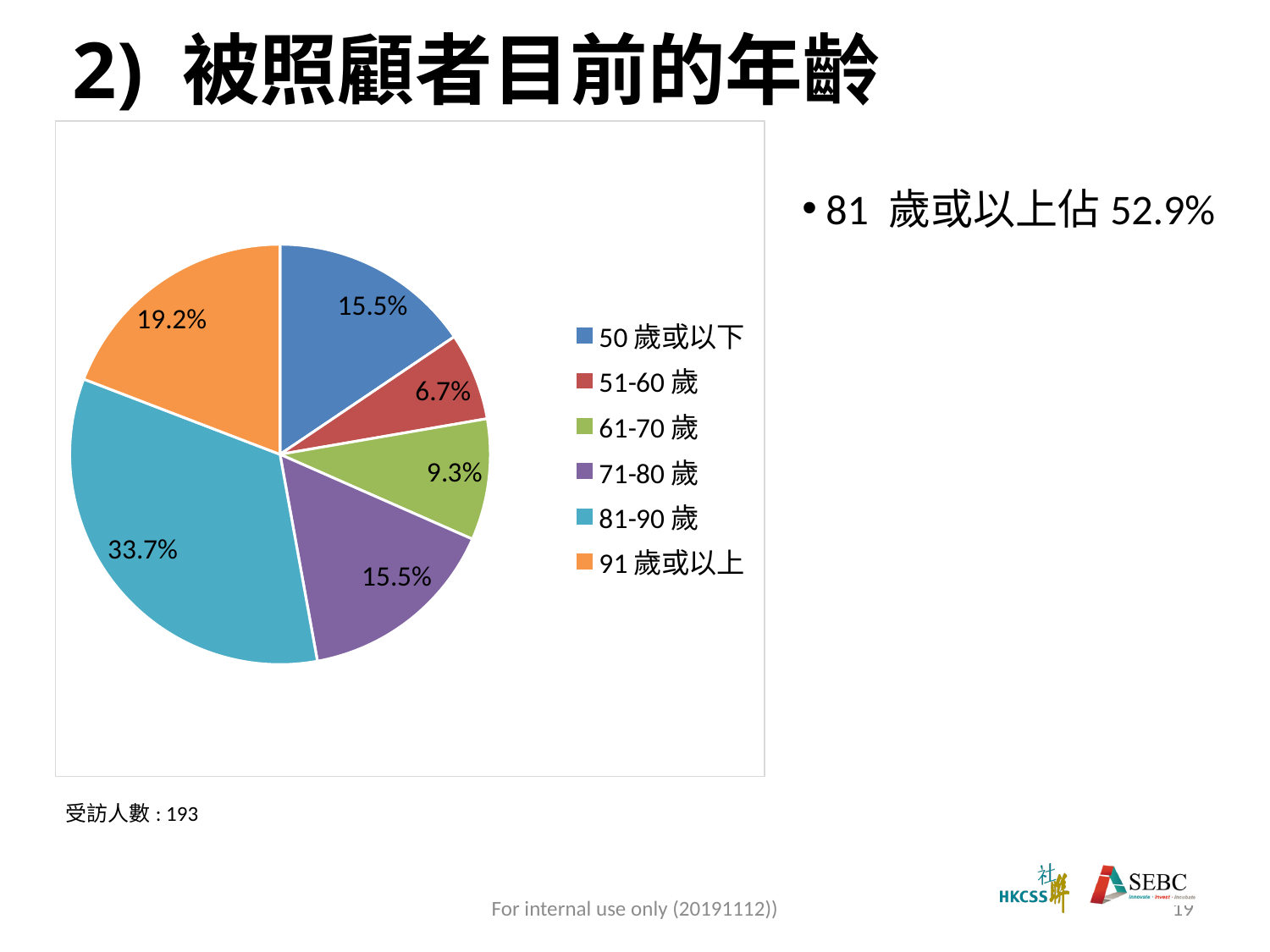
What percentage of the pie is the 51-60 歲 slice? 6.7% Which slice is larger, 61-70 歲 or 51-60 歲? 61-70 歲 What kind of chart is shown on the slide? pie chart What percentage of the pie is the 61-70 歲 slice? 9.3% What percentage of the pie is the 91 歲或以上 slice? 19.2% What is the combined share of the 81-90 歲 and 91 歲或以上 slices? 52.9% What percentage of the pie is the 81-90 歲 slice? 33.7% Which age category has the largest share of the pie? 81-90 歲 What colour is the 81-90 歲 slice in the pie chart? teal/light blue What is the difference in percentage points between the 81-90 歲 slice and the 91 歲或以上 slice? 14.5 Which age category has the smallest share of the pie? 51-60 歲 How many age categories does the pie chart show? 6